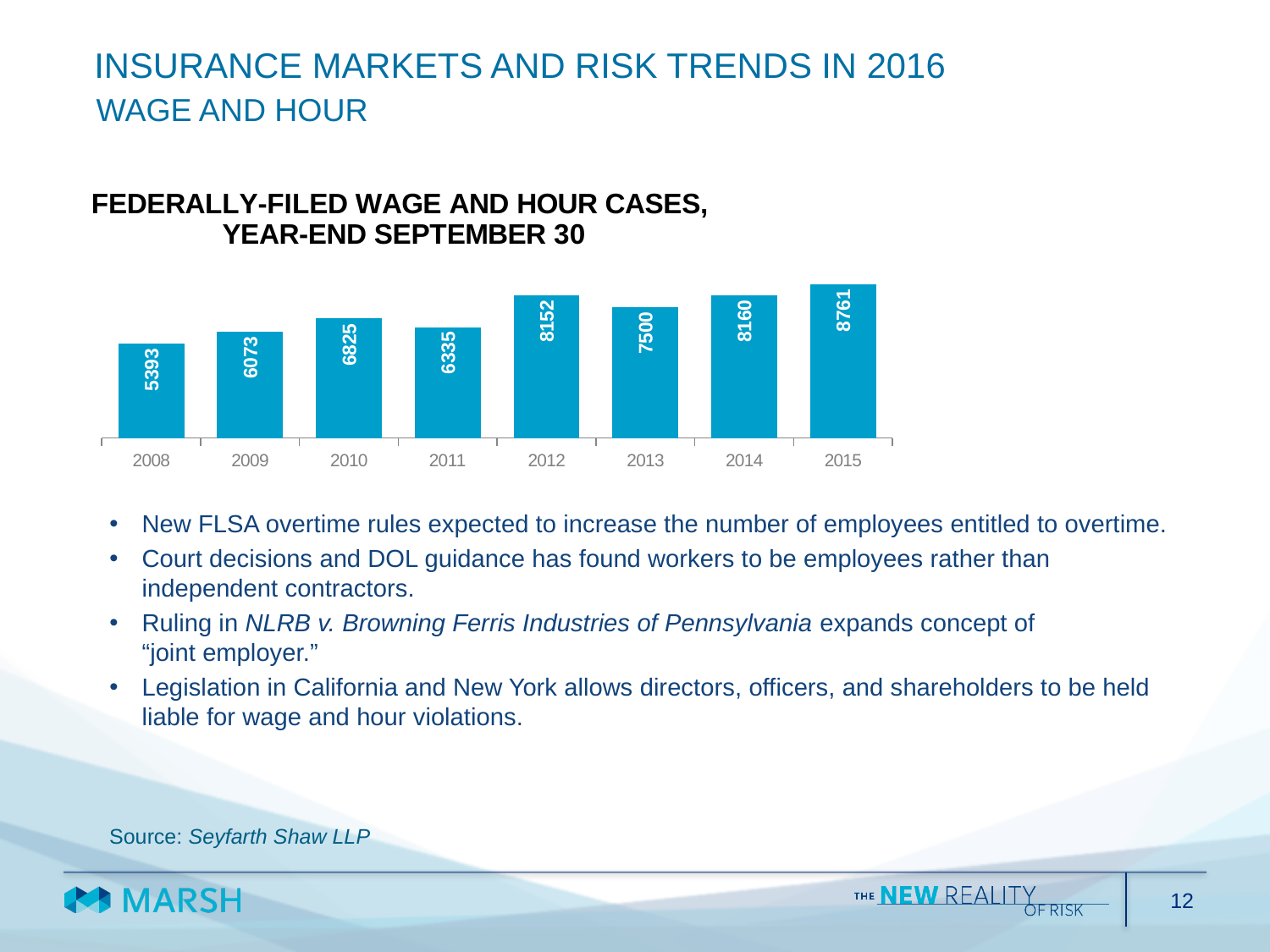
What is the number of federally-filed wage and hour cases for 2015? 8761 Overall, do the number of federally-filed wage and hour cases rise or fall from 2008 to 2015? Rise What is the number of federally-filed wage and hour cases for 2008? 5393 Which year has the lowest number of federally-filed wage and hour cases? 2008 Which year had more federally-filed wage and hour cases, 2010 or 2011? 2010 What kind of chart is used to show the federally-filed wage and hour cases? Bar chart How many years are shown in the chart? 8 What is the difference between the number of cases in 2015 and in 2008? 3368 What is the number of federally-filed wage and hour cases for 2013? 7500 What is the title of the chart on the slide? Federally-Filed Wage and Hour Cases, Year-End September 30 What is the difference between the number of cases in 2012 and in 2013? 652 Which year has the highest number of federally-filed wage and hour cases? 2015